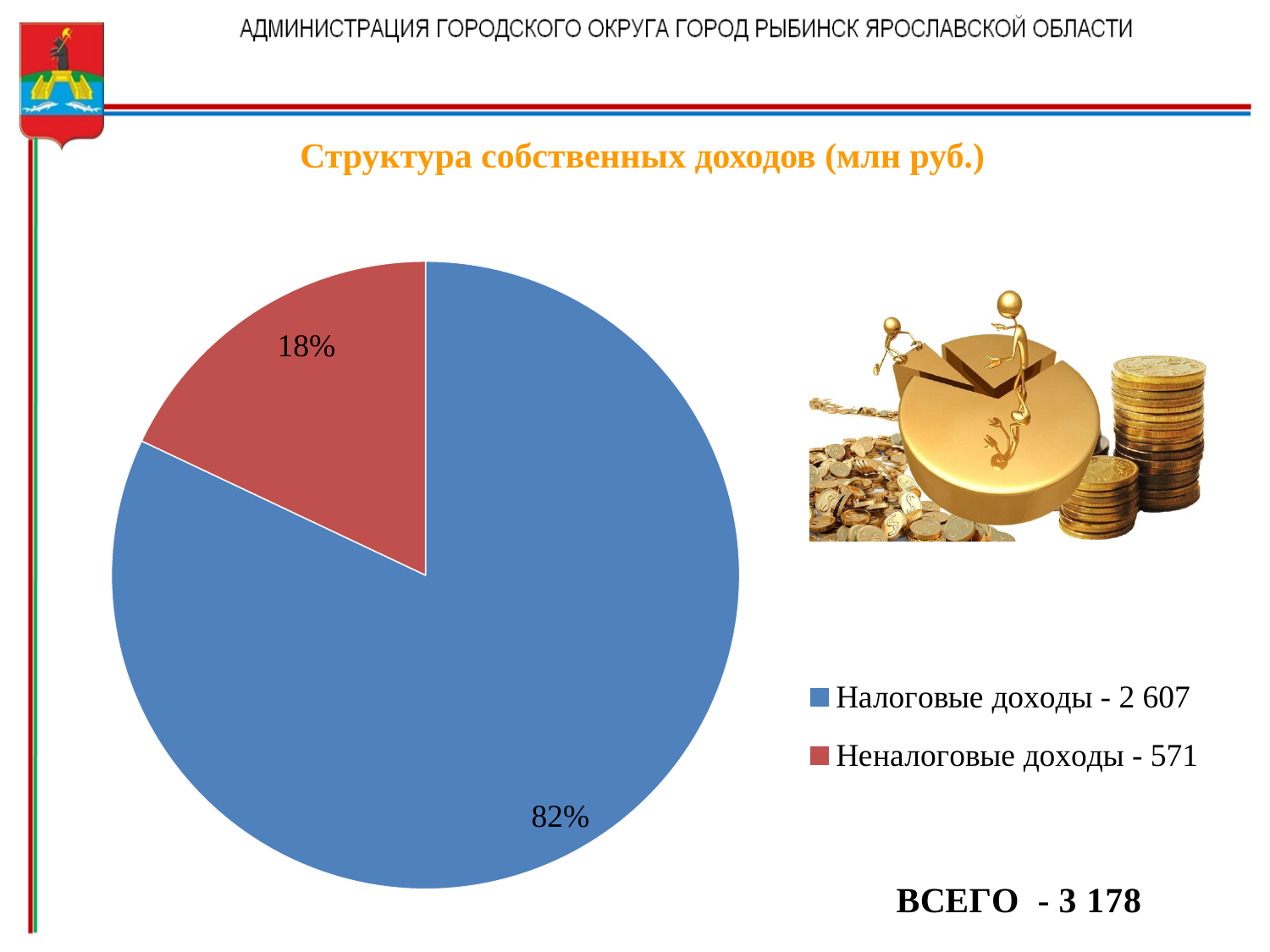
What is the difference in percentage points between the Налоговые доходы and Неналоговые доходы slices? 64 Which category has the largest slice of the pie? Налоговые доходы What share of the pie is labelled for Налоговые доходы? 82% What value does the legend give for Налоговые доходы? 2 607 What total (ВСЕГО) is shown on the slide for own revenues? 3 178 How many slices does the pie chart have? 2 What share of the pie is labelled for Неналоговые доходы? 18% What value does the legend give for Неналоговые доходы? 571 How many entries does the legend list? 2 Which category has the smallest slice of the pie? Неналоговые доходы What is the title of the chart? Структура собственных доходов (млн руб.) What kind of chart is shown on the slide? pie chart